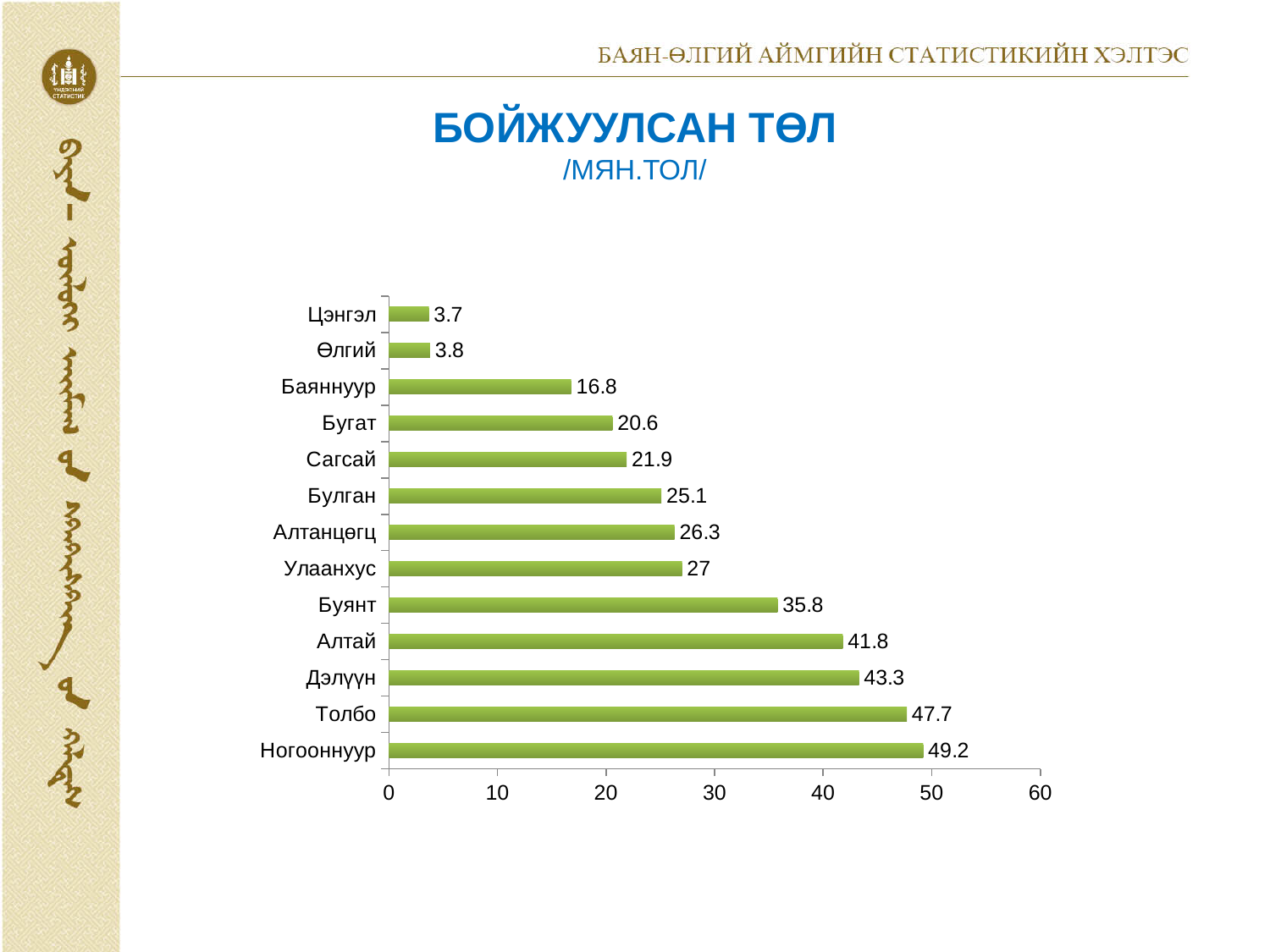
Which category has the highest value? Ногооннуур What is the value for Толбо? 47.7 Which category has the lowest value? Цэнгэл What is the difference between the values for Алтай and Буянт? 6 What is the difference between the values for Ногооннуур and Толбо? 1.5 What is the value for Баяннуур? 16.8 Is the value for Буянт greater or less than 30? greater How many categories are shown in the chart? 13 What kind of chart is shown on the slide? bar chart Which is larger, the value for Дэлүүн or the value for Булган? Дэлүүн What is the title of the chart? БОЙЖУУЛСАН ТӨЛ /МЯН.ТОЛ/ What is the value for Улаанхус? 27